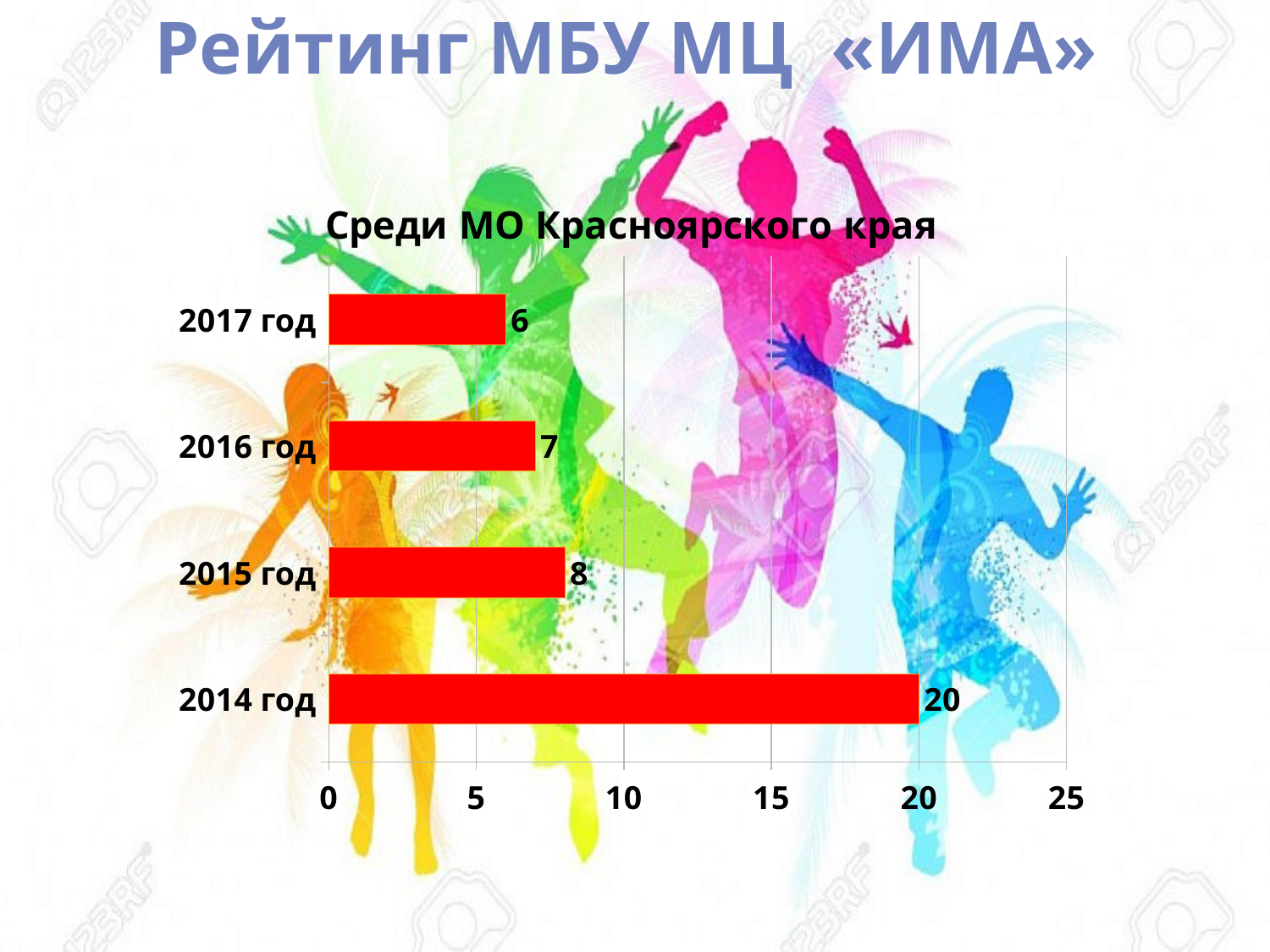
What is the value for 2014 год? 20 Which year has the highest value? 2014 год What is the value for 2015 год? 8 Which is larger, the value for 2016 год or the value for 2015 год? 2015 год What kind of chart is shown on the slide? bar chart What is the difference between the values for 2014 год and 2015 год? 12 What colour are the bars in the chart? red What is the value for 2017 год? 6 Which year has the lowest value? 2017 год What is the title of the chart? Среди МО Красноярского края How many years are shown in the chart? 4 Is the value for 2016 год greater or less than 10? less